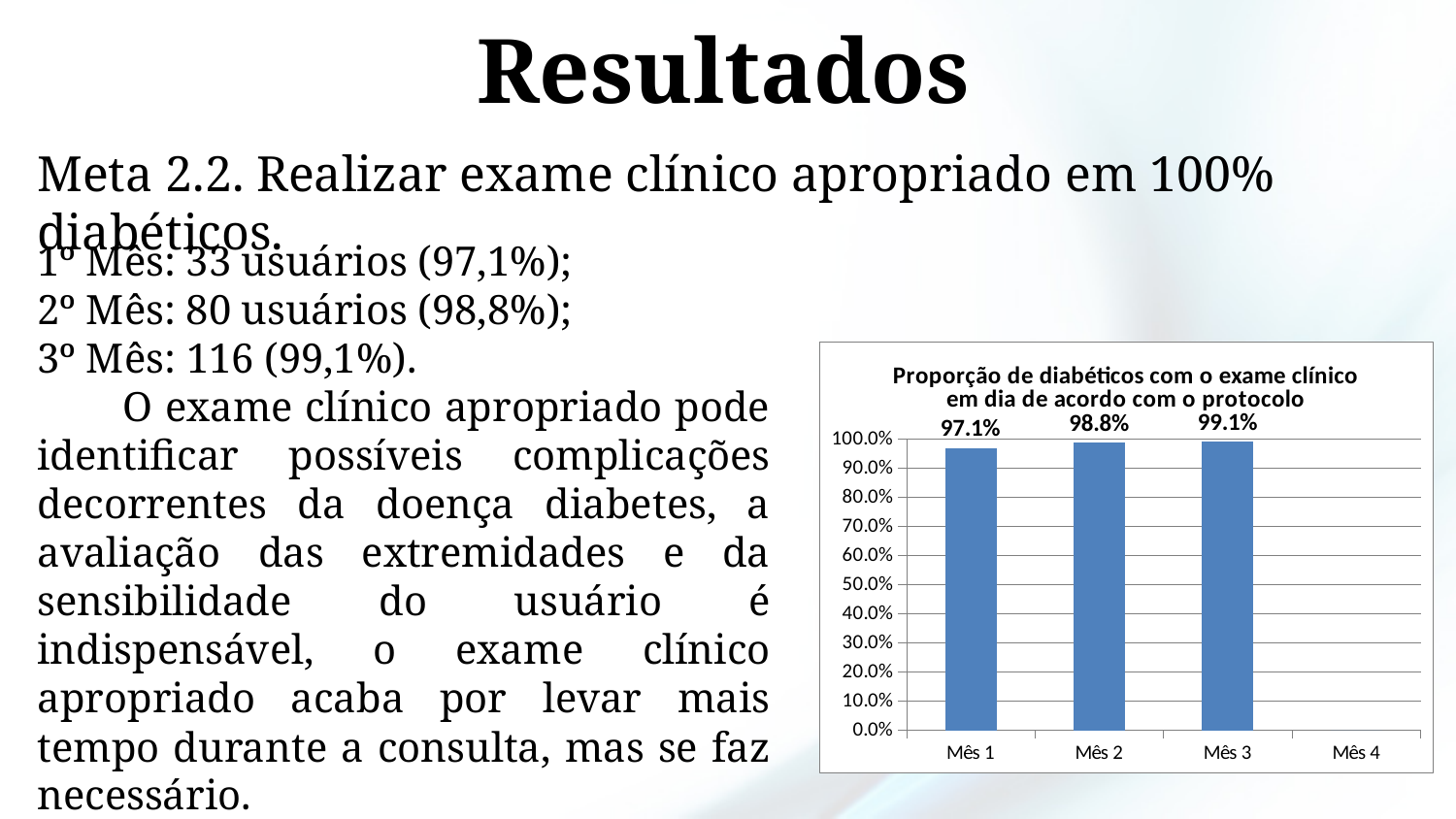
What is the value for Mês 2 in the chart? 98.8% What is the difference between the values for Mês 2 and Mês 1? 1.7% Is the value for Mês 1 greater or less than 90.0%? greater What is the value for Mês 1 in the chart? 97.1% What is the title of the chart? Proporção de diabéticos com o exame clínico em dia de acordo com o protocolo Among the months with a plotted bar, which has the lowest value? Mês 1 Which month has the highest value in the chart? Mês 3 How many categories are shown on the x axis of the chart? 4 What is the difference between the values for Mês 3 and Mês 1? 2.0% What is the value for Mês 3 in the chart? 99.1% Which is larger, the value for Mês 2 or the value for Mês 1? Mês 2 What kind of chart is shown on the slide? Bar chart